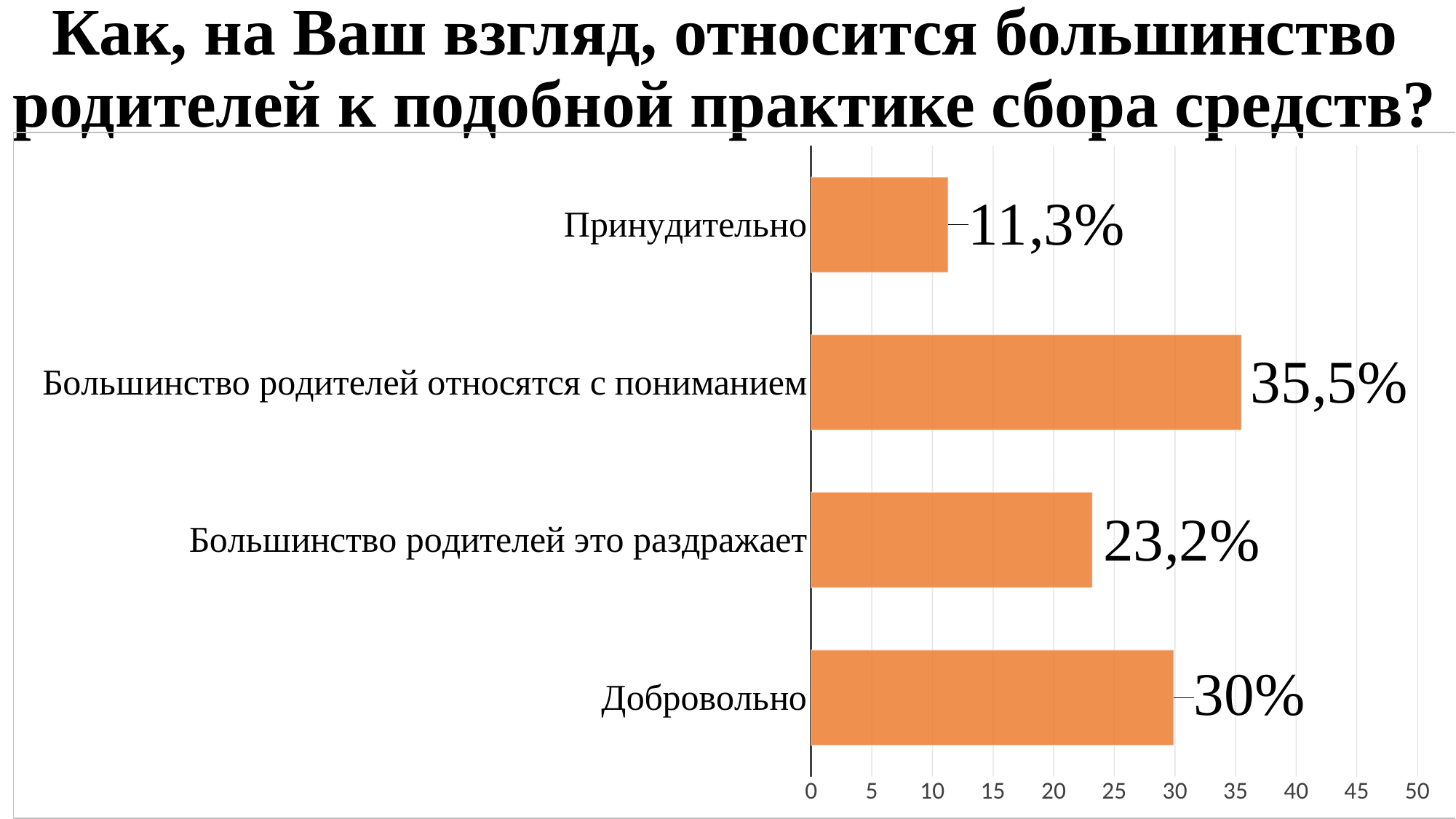
Which category has the highest value? Большинство родителей относятся с пониманием What is the value for Принудительно? 11,3% Is the value for Большинство родителей относятся с пониманием greater or less than 40? less What is the difference between the values for Большинство родителей относятся с пониманием and Большинство родителей это раздражает? 12,3% What is the difference between the values for Добровольно and Принудительно? 18,7% What is the value for Большинство родителей это раздражает? 23,2% What kind of chart is shown on the slide? bar chart What is the value for Большинство родителей относятся с пониманием? 35,5% How many categories are shown in the chart? 4 What is the value for Добровольно? 30% Which category has the lowest value? Принудительно Which is larger, the value for Добровольно or the value for Большинство родителей это раздражает? Добровольно